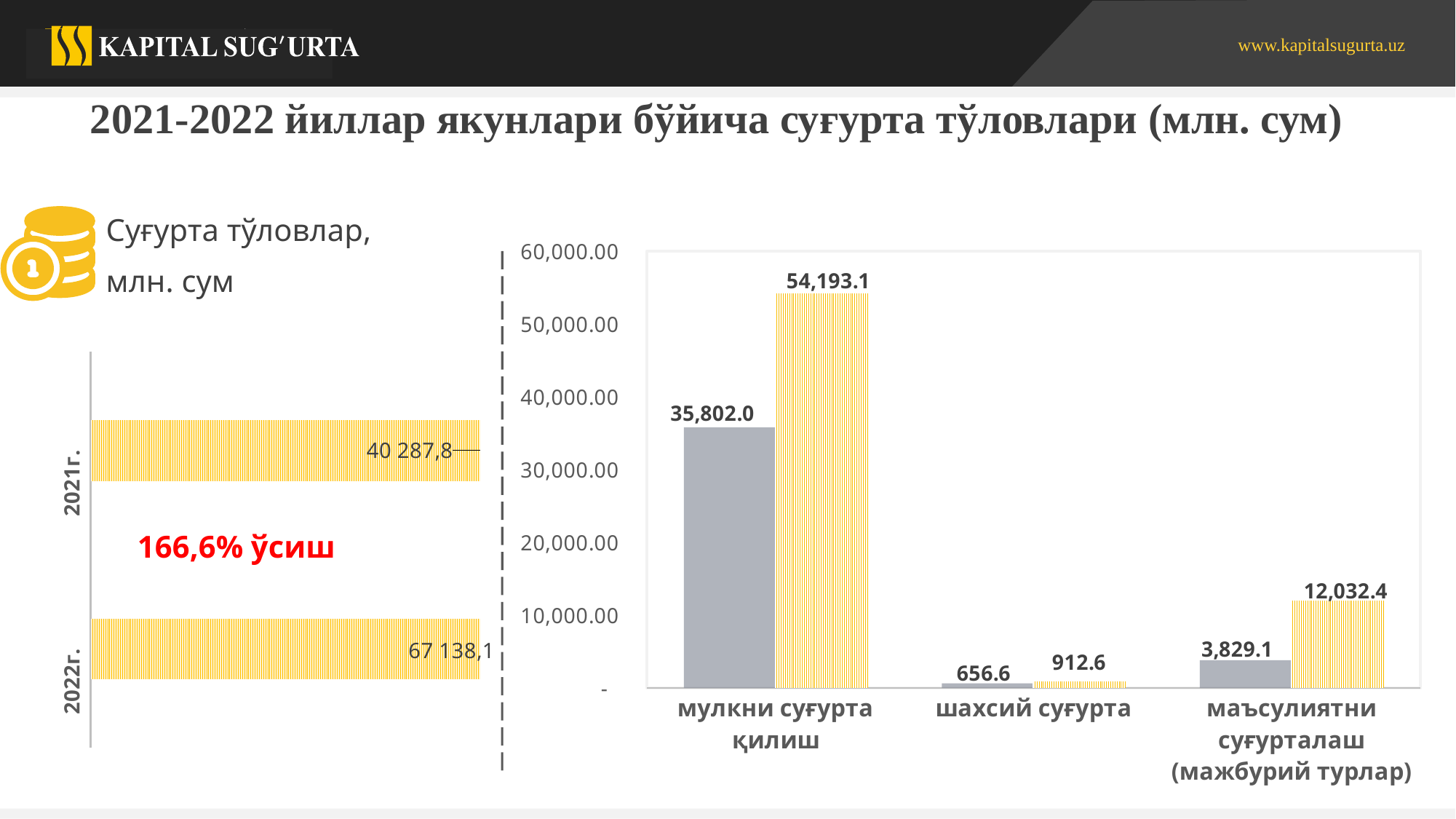
On the right chart, what is the value of the grey bar for мулкни суғурта қилиш? 35,802.0 On the left chart (Суғурта тўловлар, млн. сум), what is the difference between the 2022г. and 2021г. values? 26 850,3 On the right chart, what is the value of the yellow striped bar for мулкни суғурта қилиш? 54,193.1 On the right chart, what is the value of the grey bar for шахсий суғурта? 656.6 On the left chart (Суғурта тўловлар, млн. сум), what is the value for 2021г.? 40 287,8 On the right chart, which category has the lowest values? шахсий суғурта On the right chart, what is the difference between the yellow striped bar and the grey bar for маъсулиятни суғурталаш (мажбурий турлар)? 8,203.3 On the right chart, what is the value of the yellow striped bar for маъсулиятни суғурталаш (мажбурий турлар)? 12,032.4 On the left chart (Суғурта тўловлар, млн. сум), what is the value for 2022г.? 67 138,1 On the left chart (Суғурта тўловлар, млн. сум), what growth percentage is shown between the two bars? 166,6% ўсиш On the right chart, which category has the highest value? мулкни суғурта қилиш On the right chart, how many categories are shown on the x axis? 3